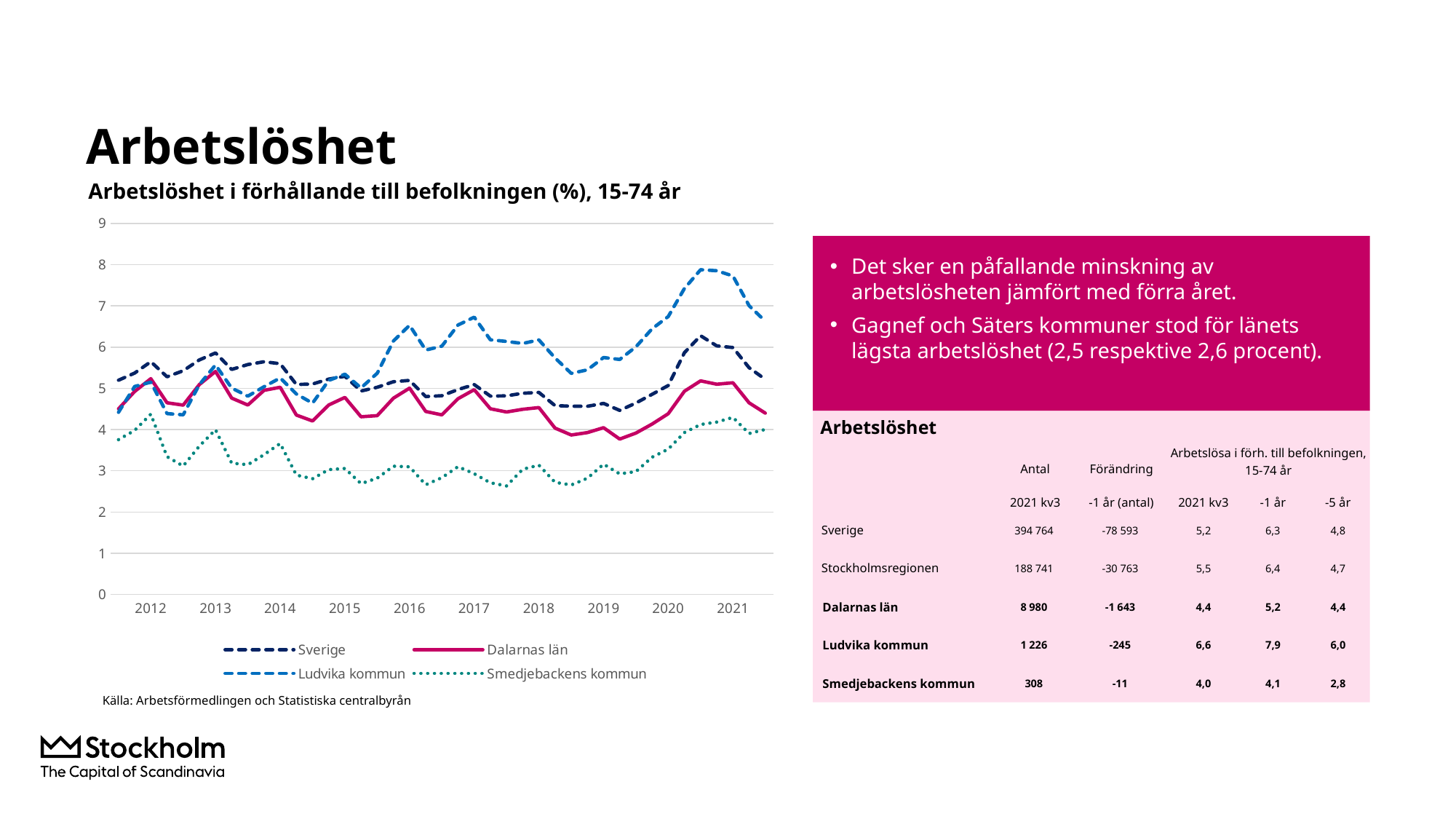
Which series has the highest value at the end of the chart in 2021? Ludvika kommun Does the value for Ludvika kommun rise or fall from its 2020 peak to the end of 2021? Fall What kind of chart is shown on the slide? Line chart Which series has the lowest values across the whole chart? Smedjebackens kommun What is the title of the chart? Arbetslöshet i förhållande till befolkningen (%), 15-74 år What is the highest value shown on the chart's y axis? 9 Is the peak value for Ludvika kommun around 2020–2021 greater or less than 7? greater How many year labels are shown on the x axis of the chart? 10 How many series does the chart legend list? 4 At the end of 2021, which is larger: the value for Ludvika kommun or the value for Dalarnas län? Ludvika kommun